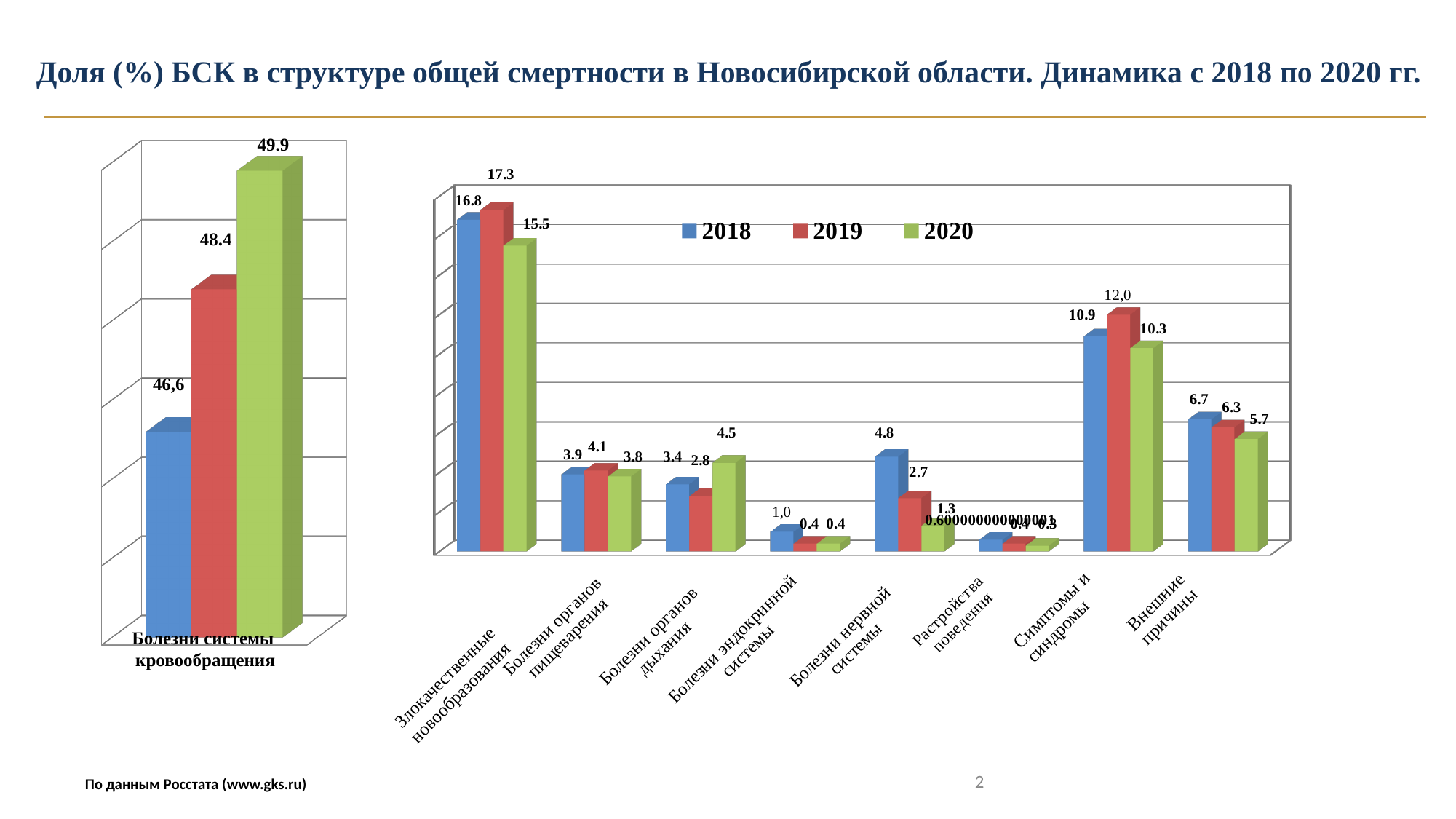
On the left chart (Болезни системы кровообращения), what value is labelled on the blue bar? 46,6 On the left chart (Болезни системы кровообращения), what is the highest value shown? 49.9 On the right chart, for Болезни нервной системы, which is larger: the 2018 value or the 2020 value? 2018 On the right chart, how many series does the legend list? 3 On the right chart, what is the difference between the 2019 value (17.3) and the 2020 value (15.5) for Злокачественные новообразования? 1.8 What kind of chart is the right chart? bar chart On the left chart (Болезни системы кровообращения), what is the difference between the green bar (49.9) and the blue bar (46,6)? 3.3 On the right chart, how many categories are shown on the x axis? 8 On the right chart, do the values for Внешние причины rise or fall from 2018 to 2020? fall On the right chart, what is the 2020 value for Болезни органов дыхания? 4.5 On the right chart, what is the 2019 value for Симптомы и синдромы? 12,0 On the right chart, which category has the highest 2018 value? Злокачественные новообразования